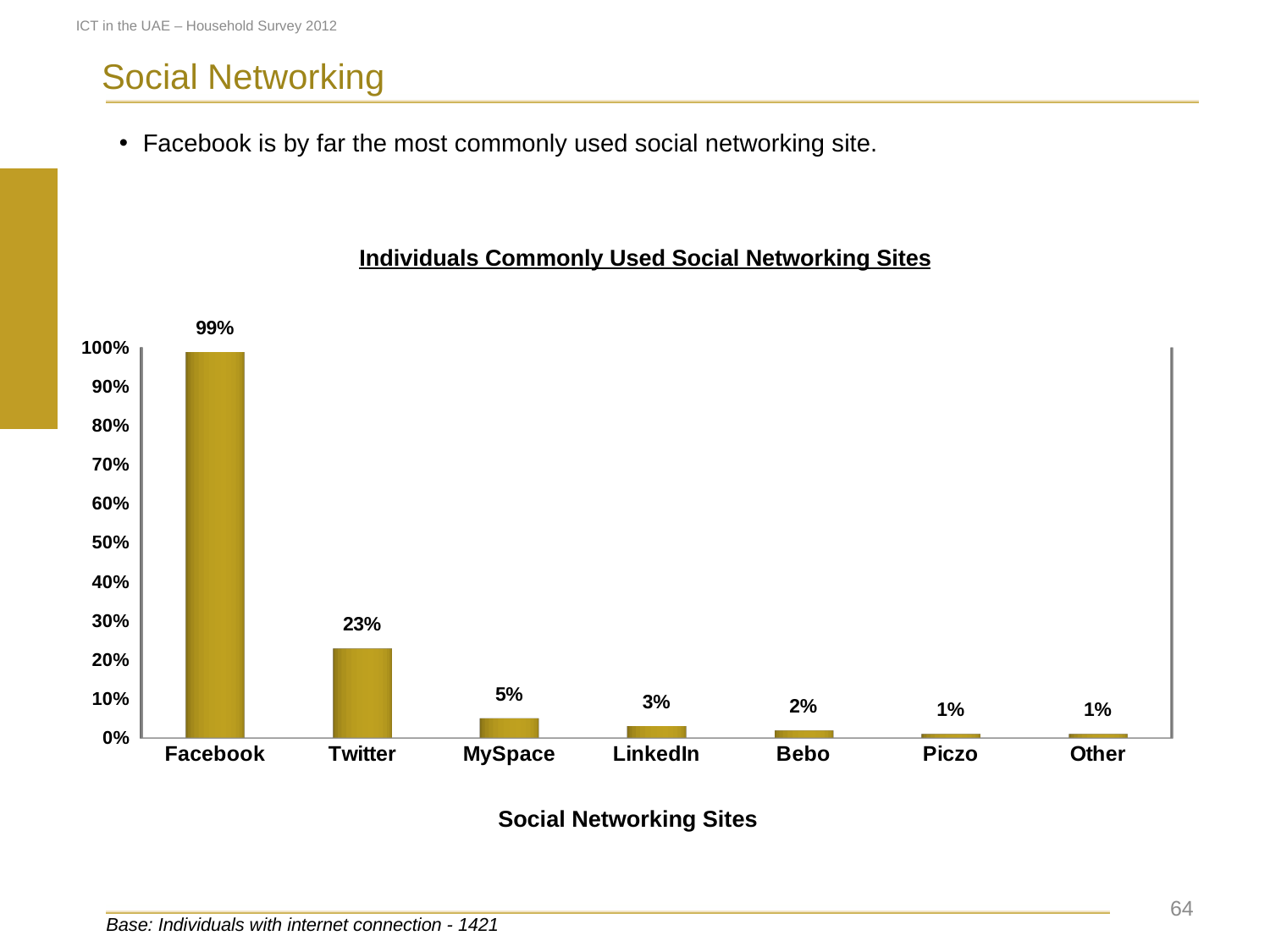
What is the value shown for MySpace? 5% What is the difference between the values for Facebook and Twitter? 76% What percentage of individuals use Facebook according to the chart? 99% How many social networking site categories are shown on the x axis? 7 Which has a larger value, Twitter or MySpace? Twitter Which social networking site has the highest value in the chart? Facebook What is the difference between the values for MySpace and LinkedIn? 2% What is the title of the chart? Individuals Commonly Used Social Networking Sites What kind of chart is shown on the slide? Bar chart What is the value shown for Twitter? 23% What is the value shown for LinkedIn? 3% Is the value for Twitter greater or less than 20%? greater